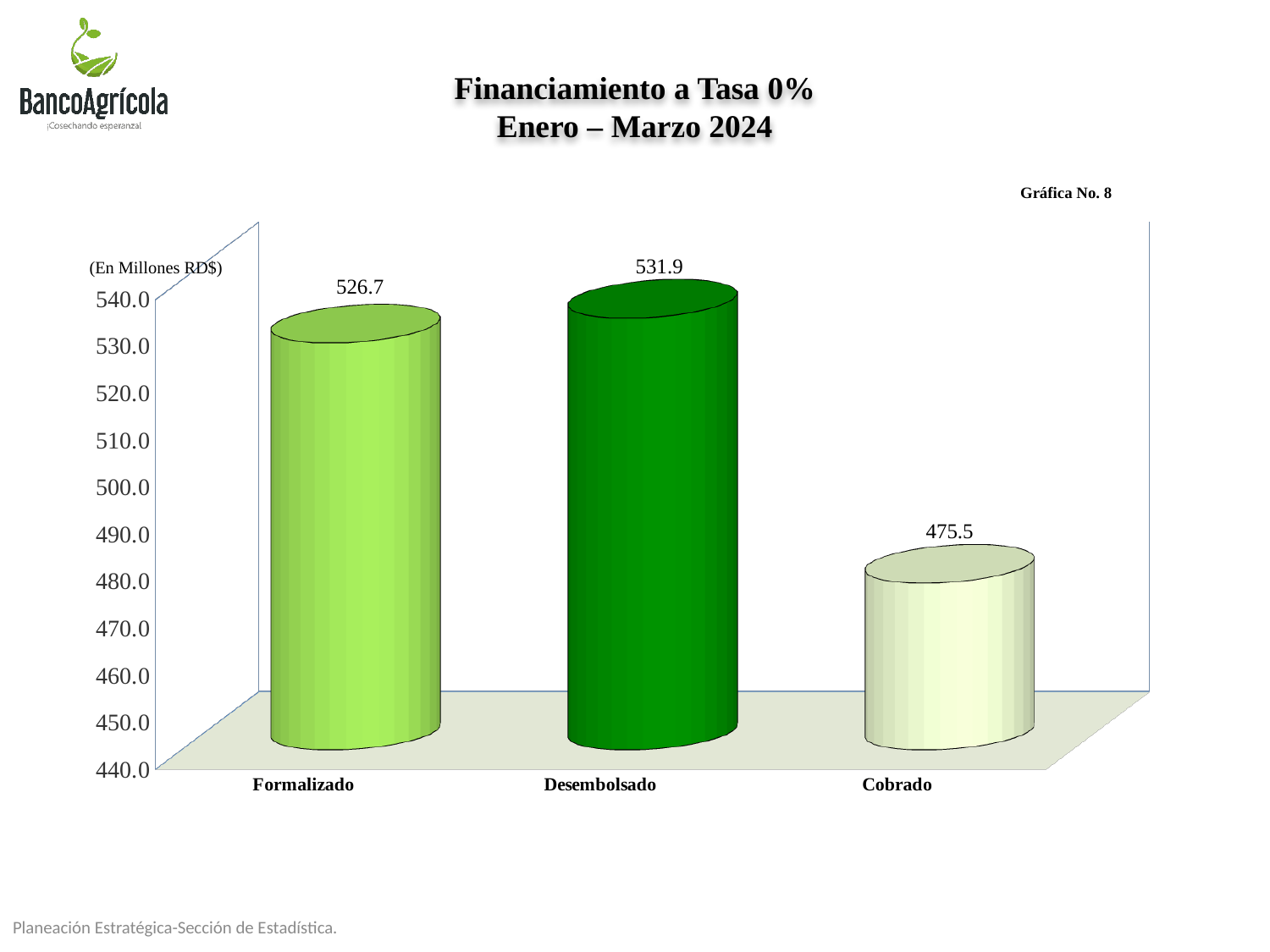
What is the value for Cobrado? 475.5 Is the value for Cobrado greater or less than 480.0? less Which is larger, the value for Formalizado or the value for Cobrado? Formalizado What is the value for Formalizado? 526.7 What is the difference between the values for Formalizado and Cobrado? 51.2 Which category has the highest value? Desembolsado What kind of chart is shown on the slide? bar chart What is the title of the chart? Financiamiento a Tasa 0% Enero – Marzo 2024 What is the difference between the values for Desembolsado and Formalizado? 5.2 Which category has the lowest value? Cobrado How many categories are shown in the chart? 3 What is the value for Desembolsado? 531.9